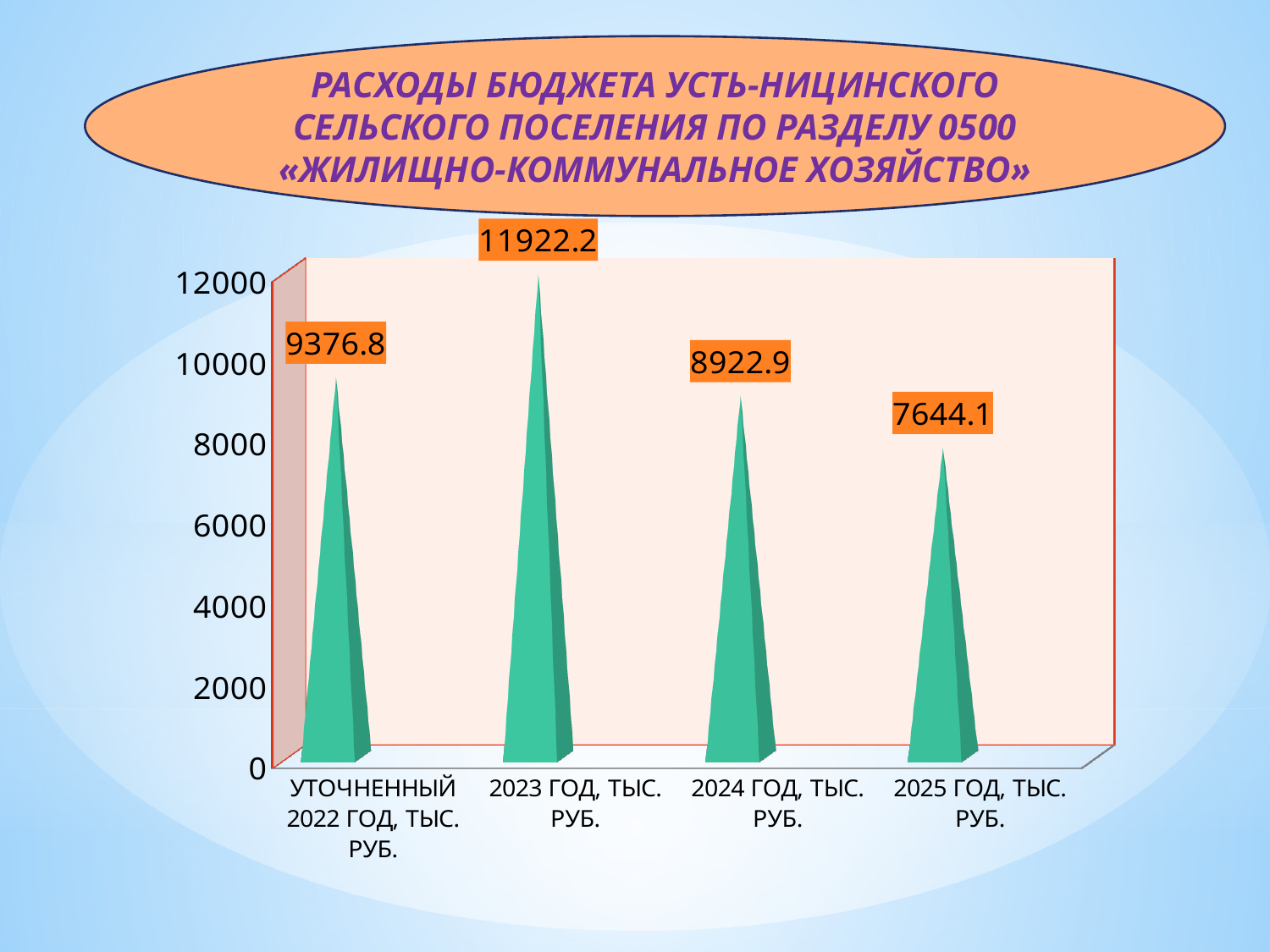
Is the value for 2024 год, тыс. руб. greater or less than 10000? less What is the difference between the values for 2023 год and Уточненный 2022 год? 2545.4 Which is larger, the value for 2024 год or the value for 2025 год? 2024 год, тыс. руб. What is the difference between the values for 2024 год and 2025 год? 1278.8 Which category has the highest value? 2023 год, тыс. руб. What kind of chart is shown on the slide? bar chart What is the value for 2023 год, тыс. руб.? 11922.2 Which category has the lowest value? 2025 год, тыс. руб. What is the value for 2025 год, тыс. руб.? 7644.1 Do the values rise or fall from 2023 год to 2025 год? fall What is the value for Уточненный 2022 год, тыс. руб.? 9376.8 How many categories are shown on the x axis? 4